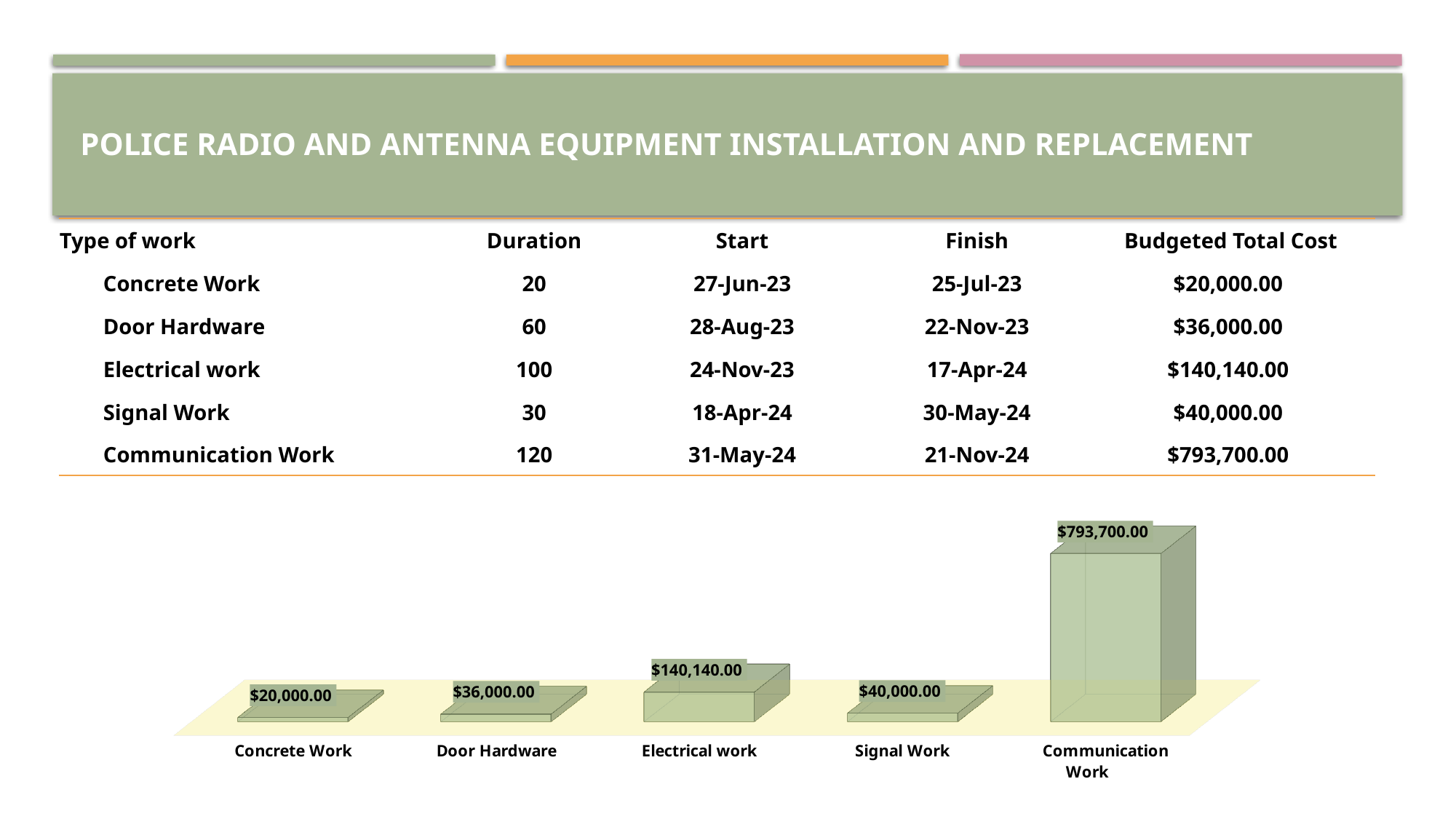
Which is larger, the value for Signal Work or the value for Door Hardware? Signal Work What is the difference between the values for Signal Work and Door Hardware? $4,000.00 What is the value shown for Communication Work in the chart? $793,700.00 What is the total of all the values shown in the chart? $1,029,840.00 What kind of chart is shown on the slide? Bar chart What is the value shown for Door Hardware in the chart? $36,000.00 How many categories are shown in the chart? 5 What is the value shown for Signal Work in the chart? $40,000.00 What is the value shown for Electrical work in the chart? $140,140.00 Which category has the highest value in the chart? Communication Work Which category has the lowest value in the chart? Concrete Work What is the difference between the values for Communication Work and Electrical work? $653,560.00